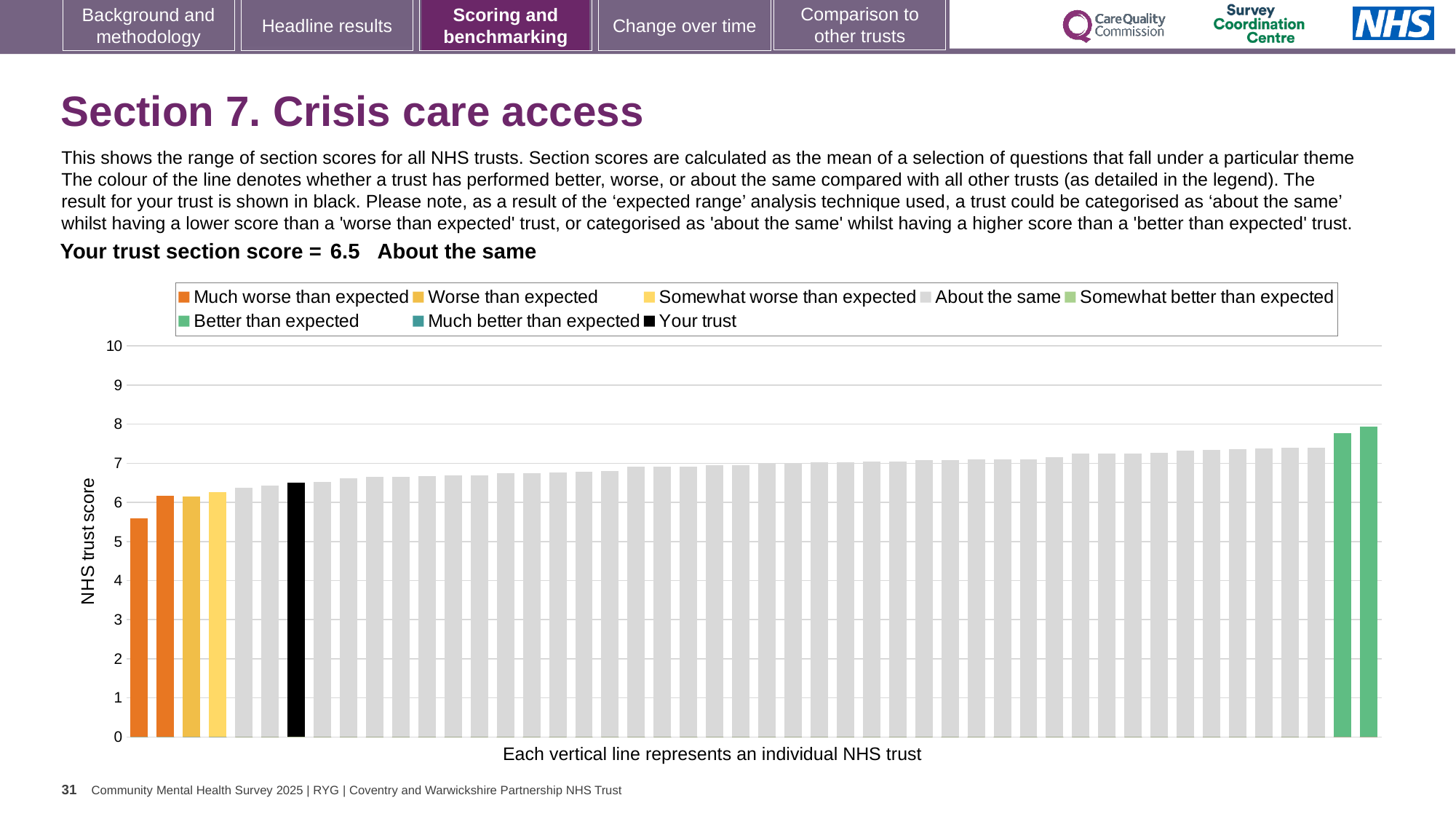
How is your trust's section score categorised compared with other trusts? About the same Which legend category do the two highest bars belong to? Better than expected What is the section score for your trust shown on the slide? 6.5 How many bars are coloured green (Better than expected)? 2 What is the label on the vertical axis of the chart? NHS trust score What kind of chart is shown on the slide? bar chart Do the bar values rise or fall from left to right along the x axis? rise How many entries does the chart legend list? 8 Is the value of the lowest bar (leftmost orange bar) greater or less than 6? less Is the value of the black 'Your trust' bar greater or less than 6? greater